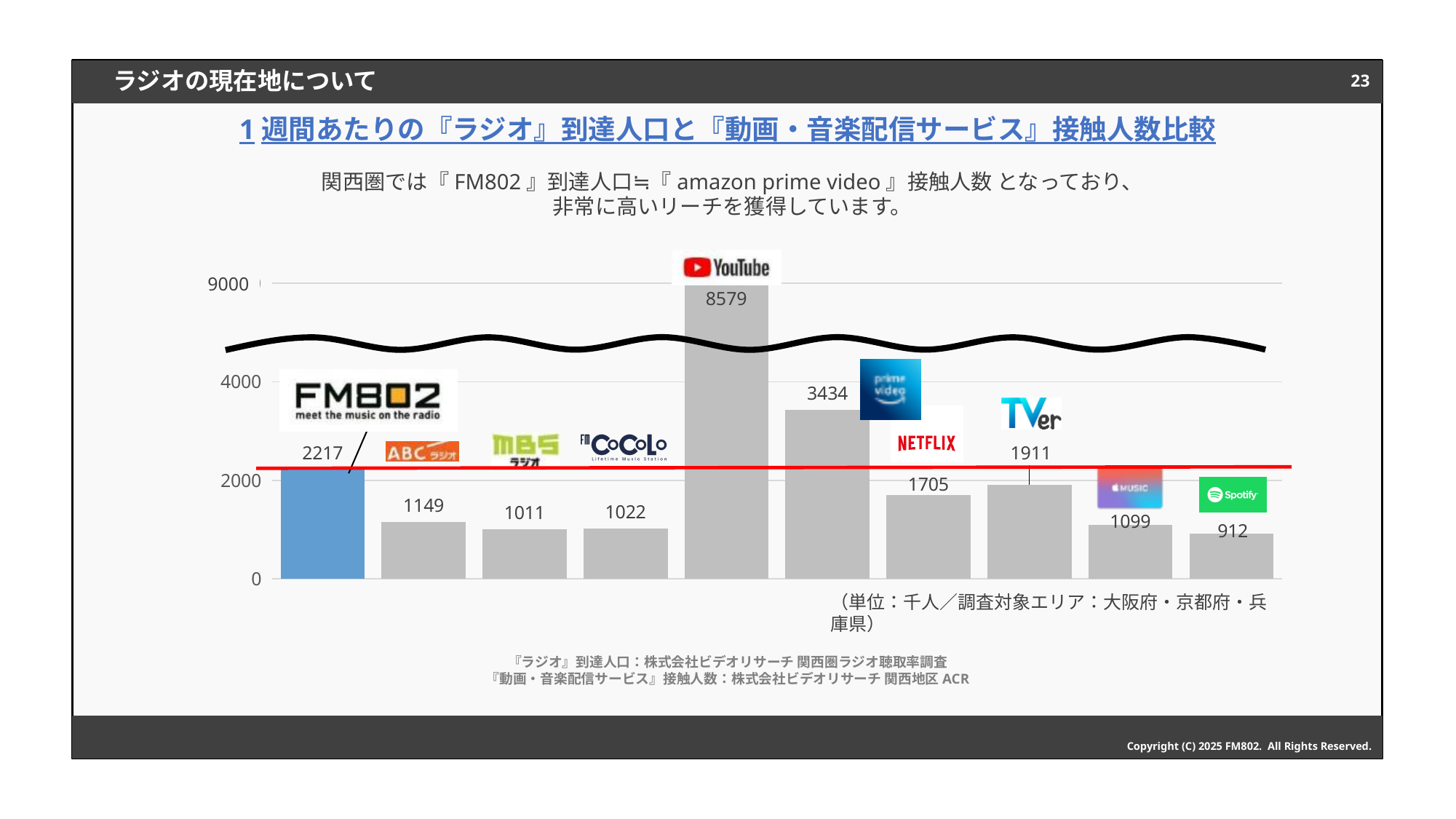
What is the value for Spotify? 912 What is the difference between the values for FM802 and TVer? 306 What kind of chart is shown on the slide? Bar chart What is the value for YouTube? 8579 Which bar is coloured blue rather than grey? FM802 What is the value for FM802? 2217 What is the value for Netflix? 1705 Which category has the lowest value? Spotify What is the value for Prime Video? 3434 Which category has the highest value? YouTube How many bars are plotted in the chart? 10 Which is larger, the value for ABC Radio or the value for Apple Music? ABC Radio